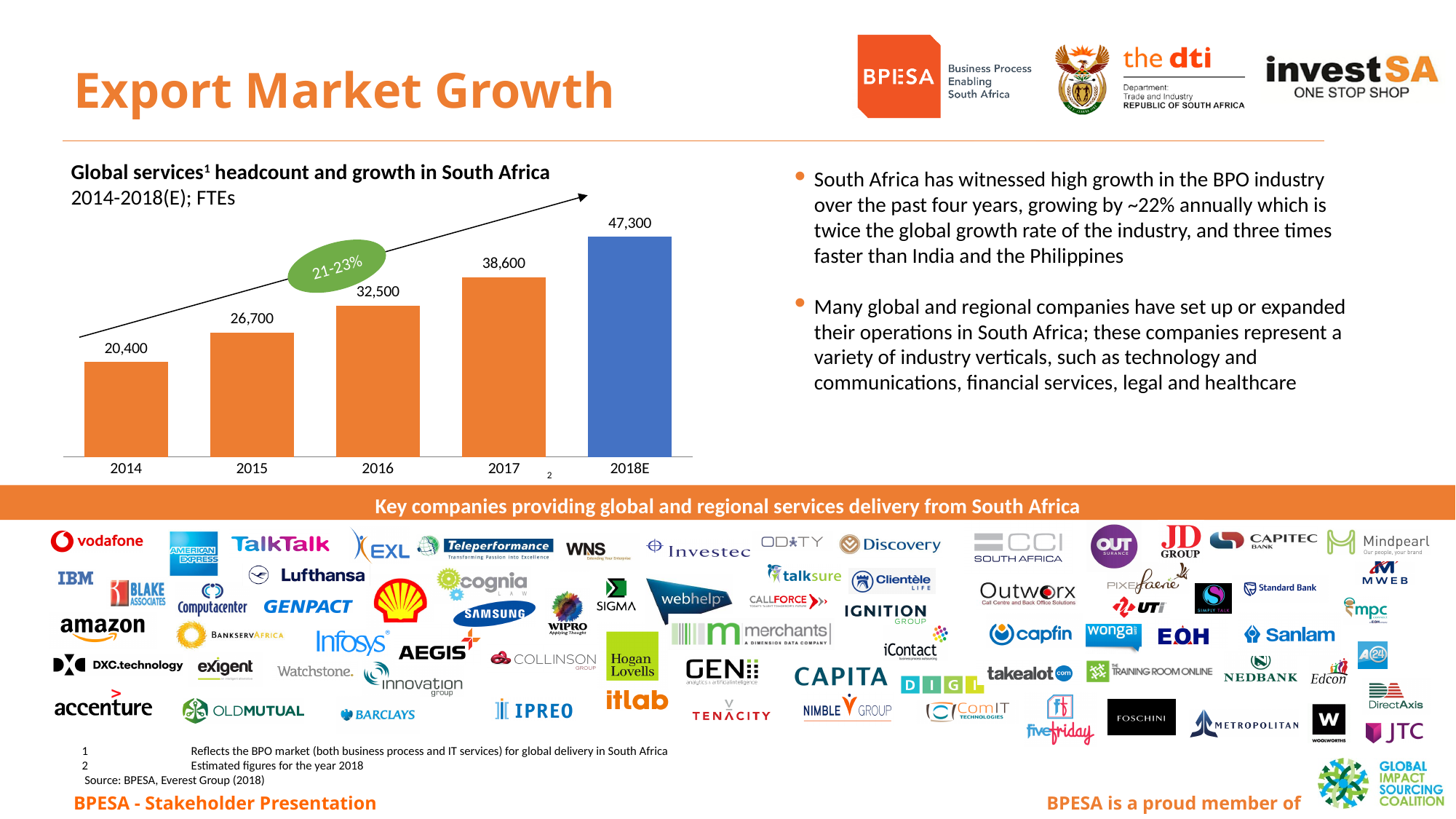
What is the headcount value shown for 2014? 20,400 Do the headcount values rise or fall from 2014 to 2018E? Rise Which year has the lowest headcount in the chart? 2014 What is the difference between the headcount for 2017 and 2016? 6,100 What kind of chart is used to show the headcount data? Bar chart What is the headcount value shown for 2018E? 47,300 What is the headcount value shown for 2016? 32,500 How many years (bars) are shown in the chart? 5 What is the difference between the headcount for 2018E and 2014? 26,900 What growth rate is shown in the green oval on the chart? 21-23% Which is larger, the headcount for 2015 or for 2017? 2017 Which year has the highest headcount in the chart? 2018E